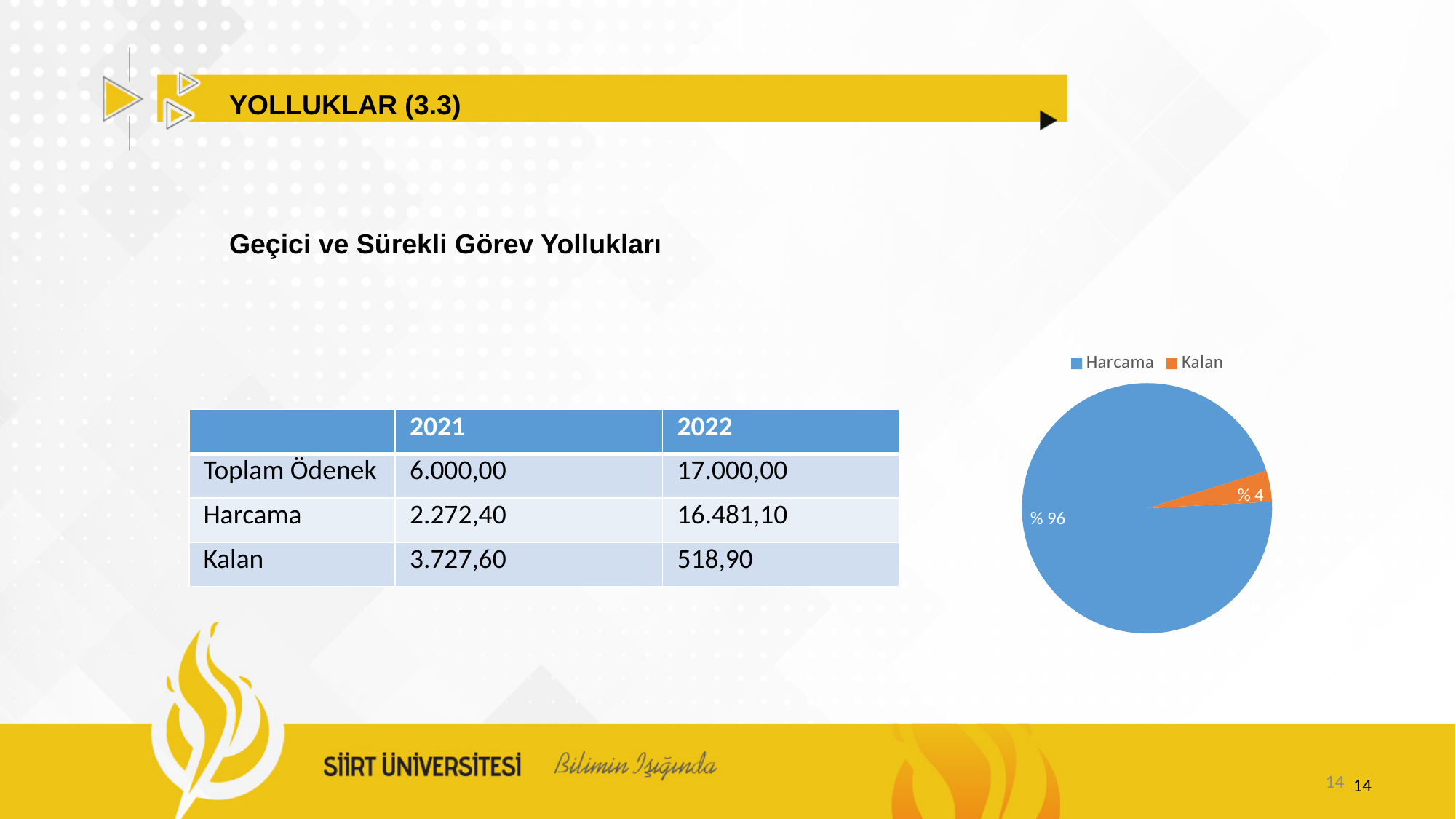
How many series does the legend of the pie chart list? 2 Which slice of the pie chart is the largest? Harcama What is the difference in percentage points between the Harcama and Kalan slices of the pie chart? 92 Which slice of the pie chart is the smallest? Kalan What colour is the Harcama slice in the pie chart? blue What share of the pie chart does Harcama take? % 96 What kind of chart is shown on the slide? pie chart What colour is the Kalan slice in the pie chart? orange In the pie chart, which is larger, Harcama or Kalan? Harcama What share of the pie chart does Kalan take? % 4 How many slices does the pie chart have? 2